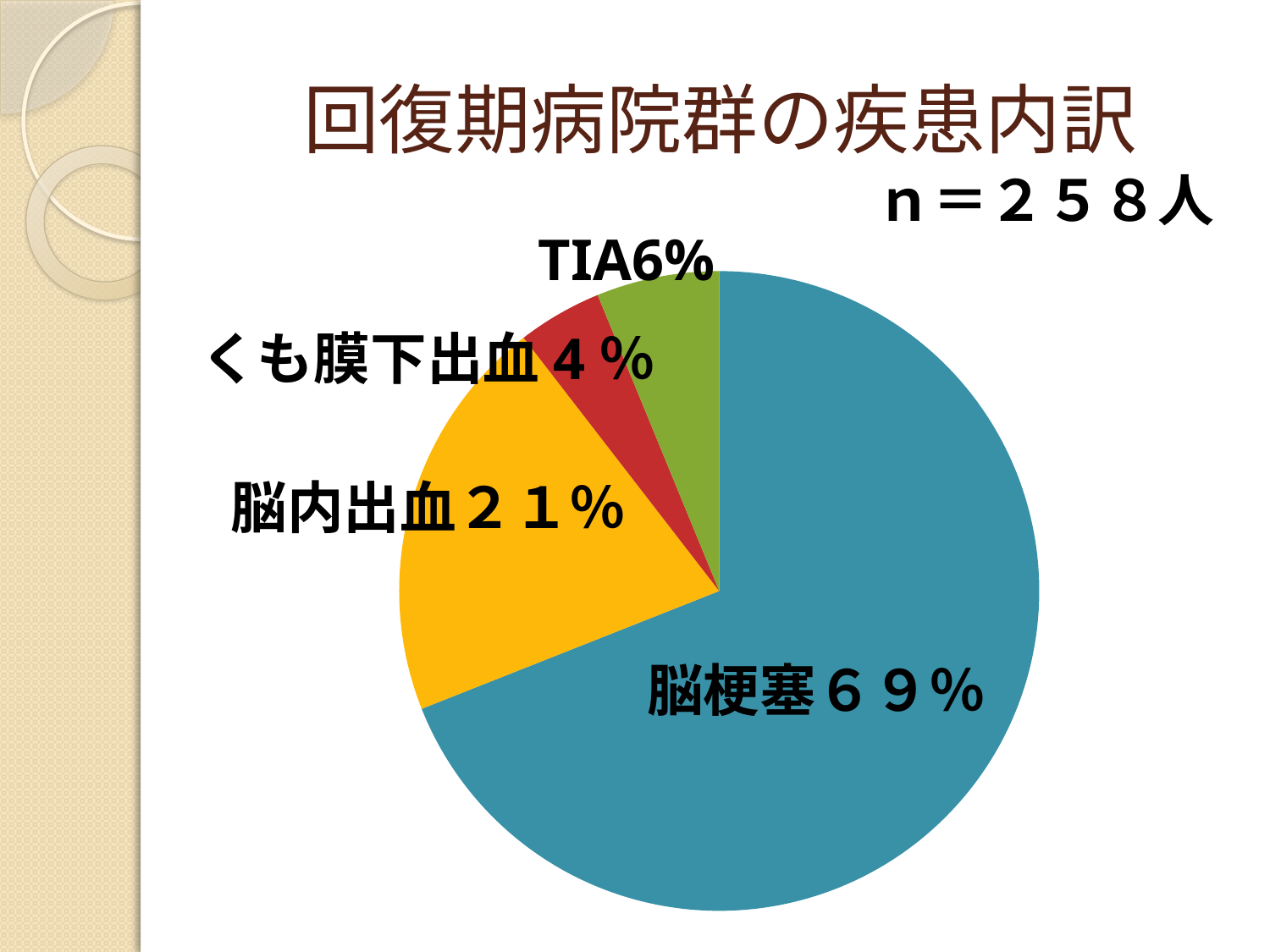
What kind of chart is shown on the slide? pie chart How many slices does the pie chart have? 4 What share of the pie does TIA account for? 6% What share of the pie does 脳梗塞 account for? ６９％ What is the title of the chart on the slide? 回復期病院群の疾患内訳 What is the sample size (n) shown on the slide? ２５８人 Which category has the smallest slice of the pie? くも膜下出血 What share of the pie does くも膜下出血 account for? ４％ Which category has the largest slice of the pie? 脳梗塞 Which is larger, the share for TIA or the share for くも膜下出血? TIA What is the difference in percentage points between 脳梗塞 and 脳内出血? 48